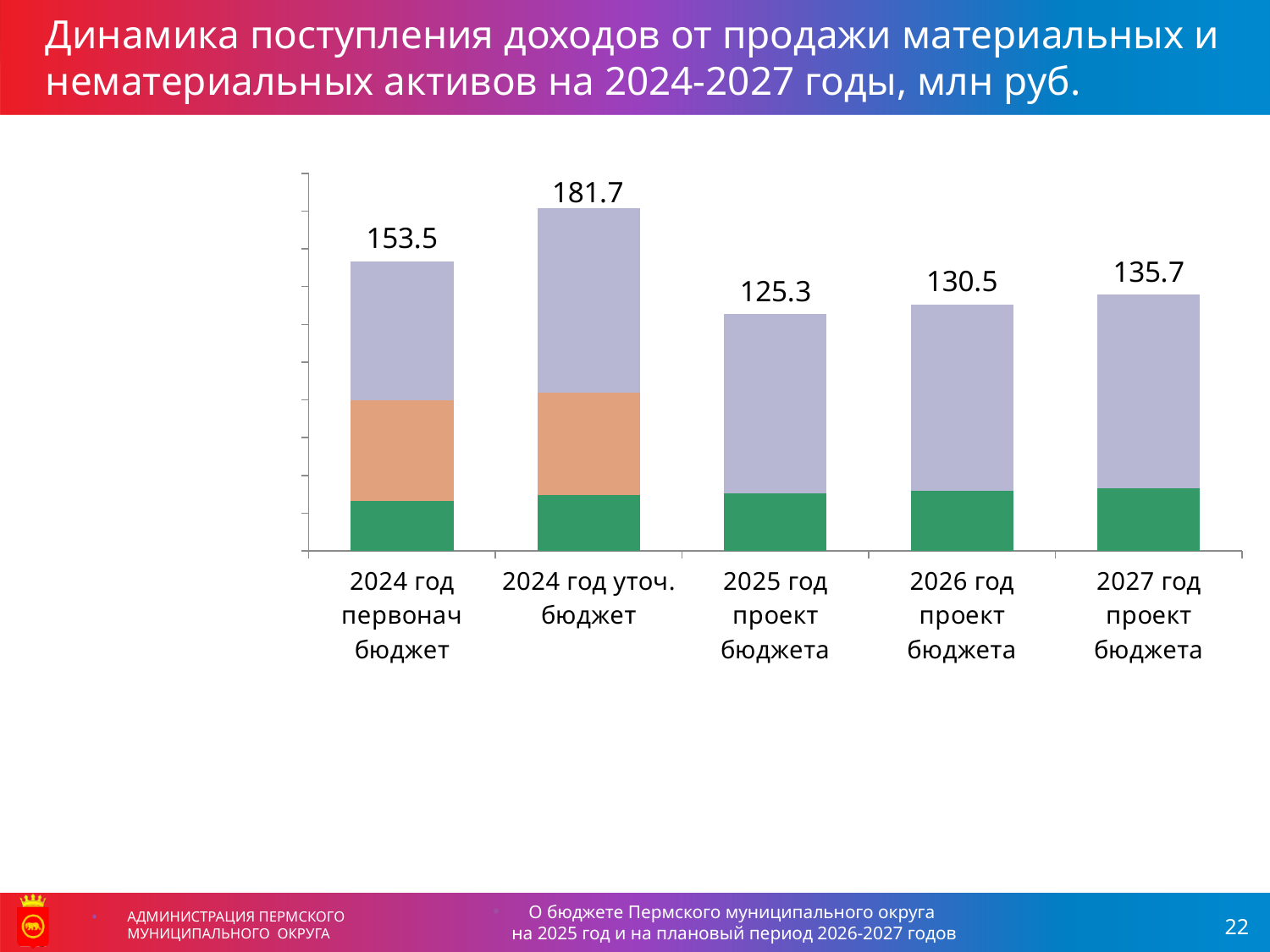
How many categories (bars) are shown on the chart? 5 What is the total value shown for the 2024 год уточ. бюджет bar? 181.7 What is the difference between the totals for 2027 год проект бюджета and 2026 год проект бюджета? 5.2 What is the total value shown for the 2025 год проект бюджета bar? 125.3 What is the difference between the totals for 2024 год уточ. бюджет and 2024 год первонач бюджет? 28.2 What is the total value shown for the 2024 год первонач бюджет bar? 153.5 Which category has the lowest total value? 2025 год проект бюджета Which category has the highest total value? 2024 год уточ. бюджет What is the total value shown for the 2027 год проект бюджета bar? 135.7 What kind of chart is shown on the slide? Stacked bar chart Do the totals rise or fall from 2025 год проект бюджета to 2027 год проект бюджета? Rise Which is larger: the total for 2026 год проект бюджета or for 2025 год проект бюджета? 2026 год проект бюджета